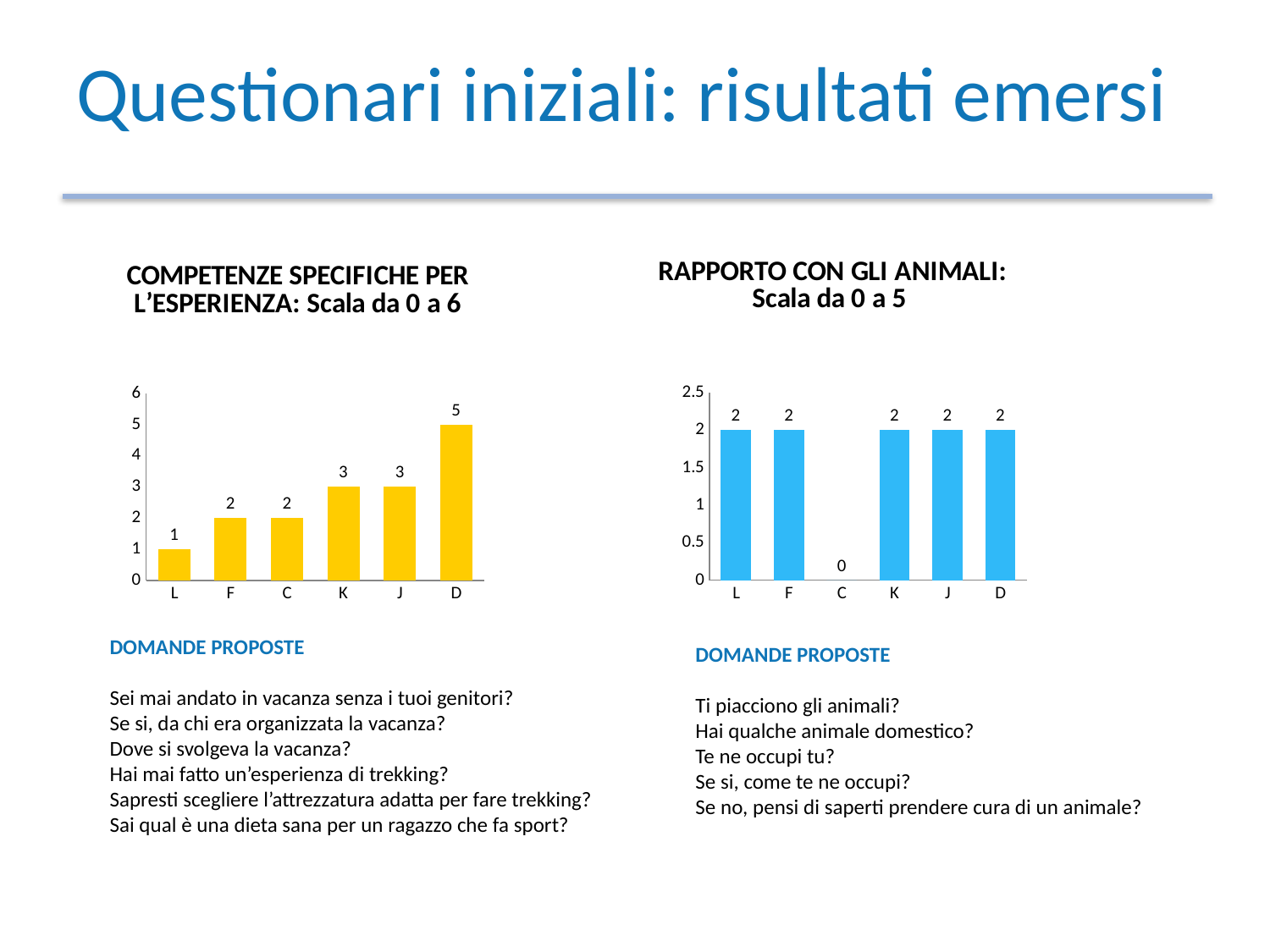
How many categories are shown in the 'COMPETENZE SPECIFICHE PER L'ESPERIENZA' chart? 6 In the 'RAPPORTO CON GLI ANIMALI' chart, what is the value for C? 0 In the 'COMPETENZE SPECIFICHE PER L'ESPERIENZA' chart, what is the value for L? 1 What colour are the bars in the 'COMPETENZE SPECIFICHE PER L'ESPERIENZA' chart? yellow What kind of chart is the 'RAPPORTO CON GLI ANIMALI' chart? bar chart In the 'COMPETENZE SPECIFICHE PER L'ESPERIENZA' chart, which category has the lowest value? L In the 'RAPPORTO CON GLI ANIMALI' chart, what is the difference between the values for K and C? 2 In the 'COMPETENZE SPECIFICHE PER L'ESPERIENZA' chart, which category has the highest value? D In the 'COMPETENZE SPECIFICHE PER L'ESPERIENZA' chart, what is the value for D? 5 In the 'COMPETENZE SPECIFICHE PER L'ESPERIENZA' chart, what is the difference between the values for D and K? 2 In the 'RAPPORTO CON GLI ANIMALI' chart, which category has the lowest value? C In the 'COMPETENZE SPECIFICHE PER L'ESPERIENZA' chart, which is larger, the value for F or the value for J? J